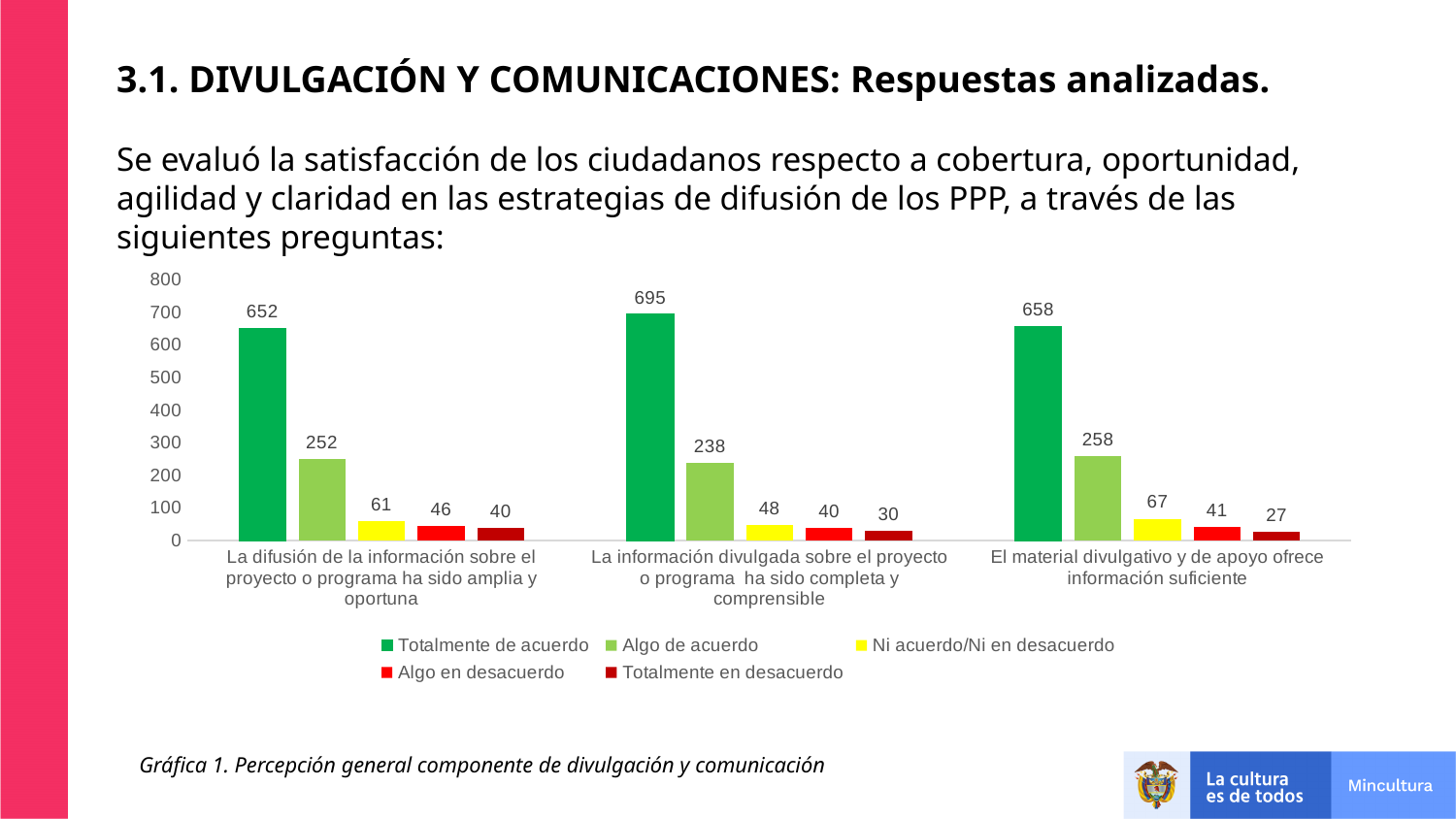
How many series does the legend list? 5 What colour represents the "Ni acuerdo/Ni en desacuerdo" series? Yellow What kind of chart is shown on the slide? Bar chart What is the value for "Ni acuerdo/Ni en desacuerdo" in the category "La difusión de la información sobre el proyecto o programa ha sido amplia y oportuna"? 61 What is the value for "Totalmente de acuerdo" in the category "La información divulgada sobre el proyecto o programa ha sido completa y comprensible"? 695 Which is larger: "Algo en desacuerdo" in "La difusión de la información sobre el proyecto o programa ha sido amplia y oportuna" or "Algo en desacuerdo" in "La información divulgada sobre el proyecto o programa ha sido completa y comprensible"? La difusión de la información sobre el proyecto o programa ha sido amplia y oportuna Is the value for "Totalmente de acuerdo" in "El material divulgativo y de apoyo ofrece información suficiente" greater or less than 600? greater What is the value for "Algo de acuerdo" in the category "El material divulgativo y de apoyo ofrece información suficiente"? 258 Which category has the highest value for "Totalmente de acuerdo"? La información divulgada sobre el proyecto o programa ha sido completa y comprensible What is the difference between "Totalmente de acuerdo" and "Algo de acuerdo" in the category "La difusión de la información sobre el proyecto o programa ha sido amplia y oportuna"? 400 Which category has the lowest value for "Totalmente en desacuerdo"? El material divulgativo y de apoyo ofrece información suficiente How many categories are shown on the x axis? 3